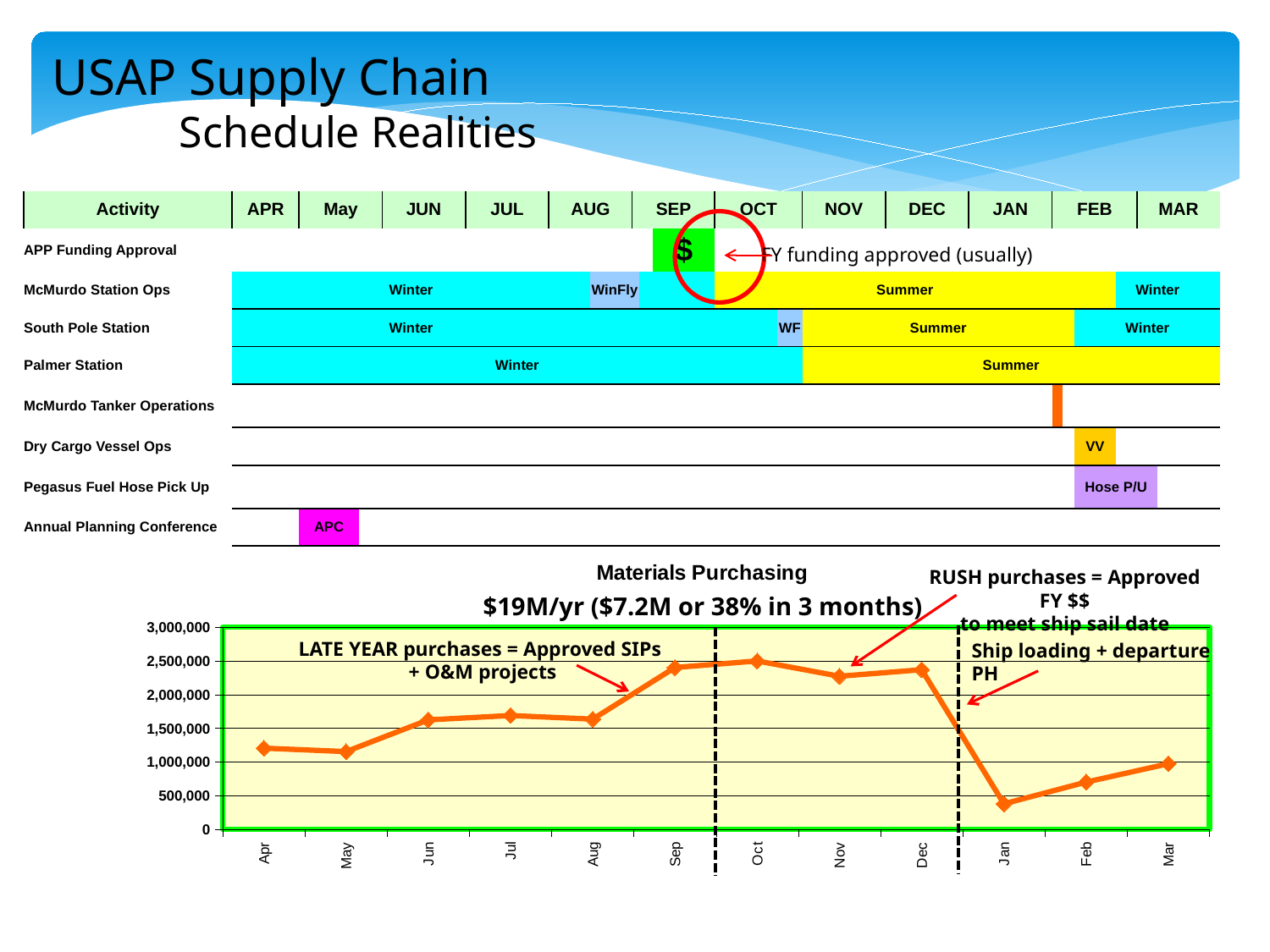
In the Materials Purchasing chart, which is larger, the value for Aug or the value for Sep? Sep In the Materials Purchasing chart, is the value for Jan greater or less than 500,000? less In the Materials Purchasing chart, which is larger, the value for Jan or the value for Mar? Mar In the Materials Purchasing chart, do the values rise or fall from Dec to Jan? fall In the Materials Purchasing chart, is the value for Oct greater or less than 2,000,000? greater In the Materials Purchasing chart, is the value for Apr greater or less than 1,000,000? greater What kind of chart is the Materials Purchasing chart? line chart How many months are plotted on the x axis of the Materials Purchasing chart? 12 In the Materials Purchasing chart, which month has the lowest value? Jan What annual total is stated in the subtitle of the Materials Purchasing chart? $19M/yr